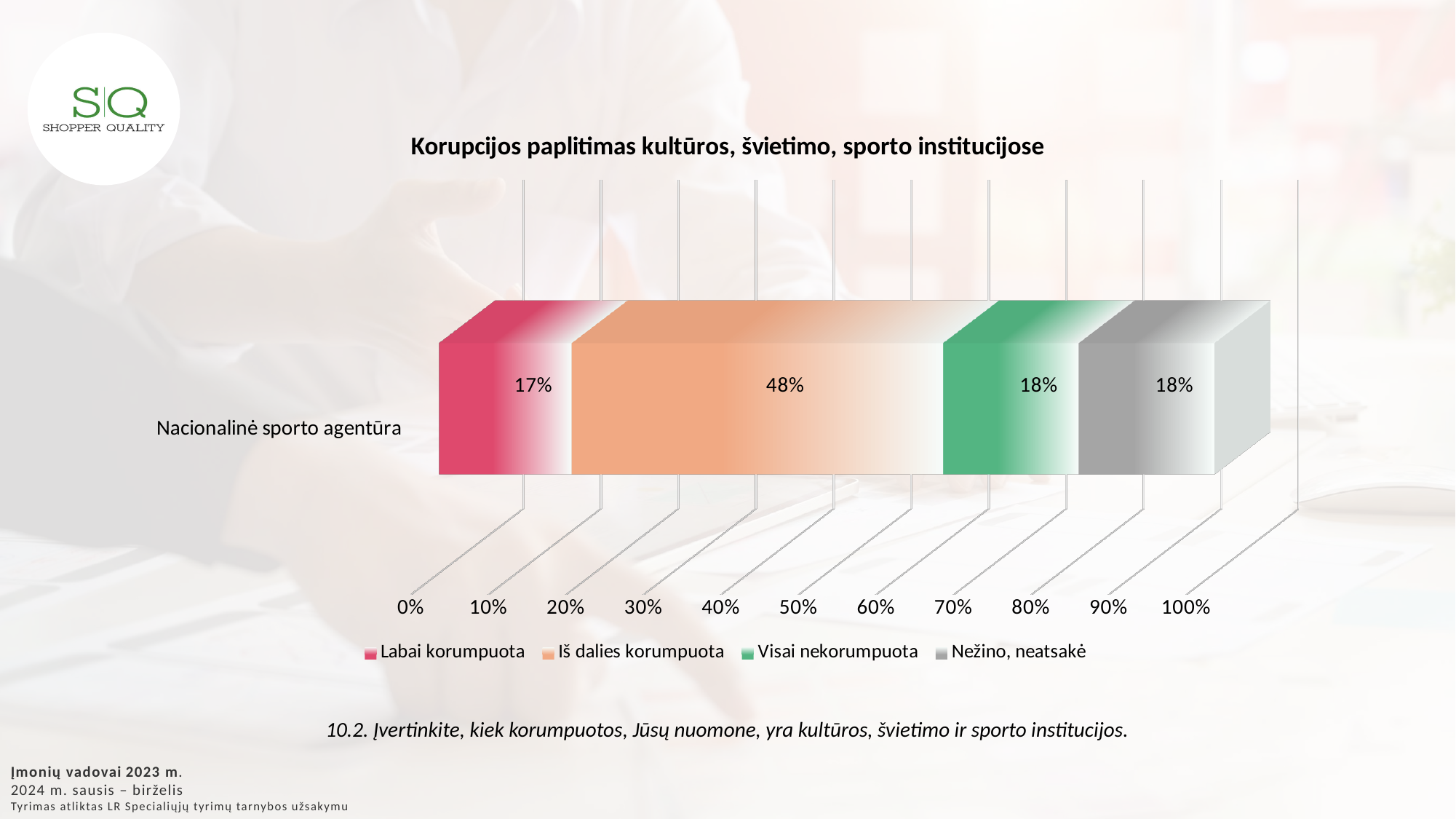
How many series does the legend list? 4 What kind of chart is shown on the slide? Stacked bar chart Which series has the lowest value for Nacionalinė sporto agentūra? Labai korumpuota What is the value for "Labai korumpuota" for Nacionalinė sporto agentūra? 17% What is the title of the chart? Korupcijos paplitimas kultūros, švietimo, sporto institucijose Which is larger: the "Iš dalies korumpuota" value or the "Visai nekorumpuota" value? Iš dalies korumpuota What is the value for "Iš dalies korumpuota" for Nacionalinė sporto agentūra? 48% How many categories are shown on the chart? 1 Which series has the highest value for Nacionalinė sporto agentūra? Iš dalies korumpuota What is the value for "Nežino, neatsakė" for Nacionalinė sporto agentūra? 18% What is the value for "Visai nekorumpuota" for Nacionalinė sporto agentūra? 18% What is the difference between the "Iš dalies korumpuota" and "Labai korumpuota" values? 31%